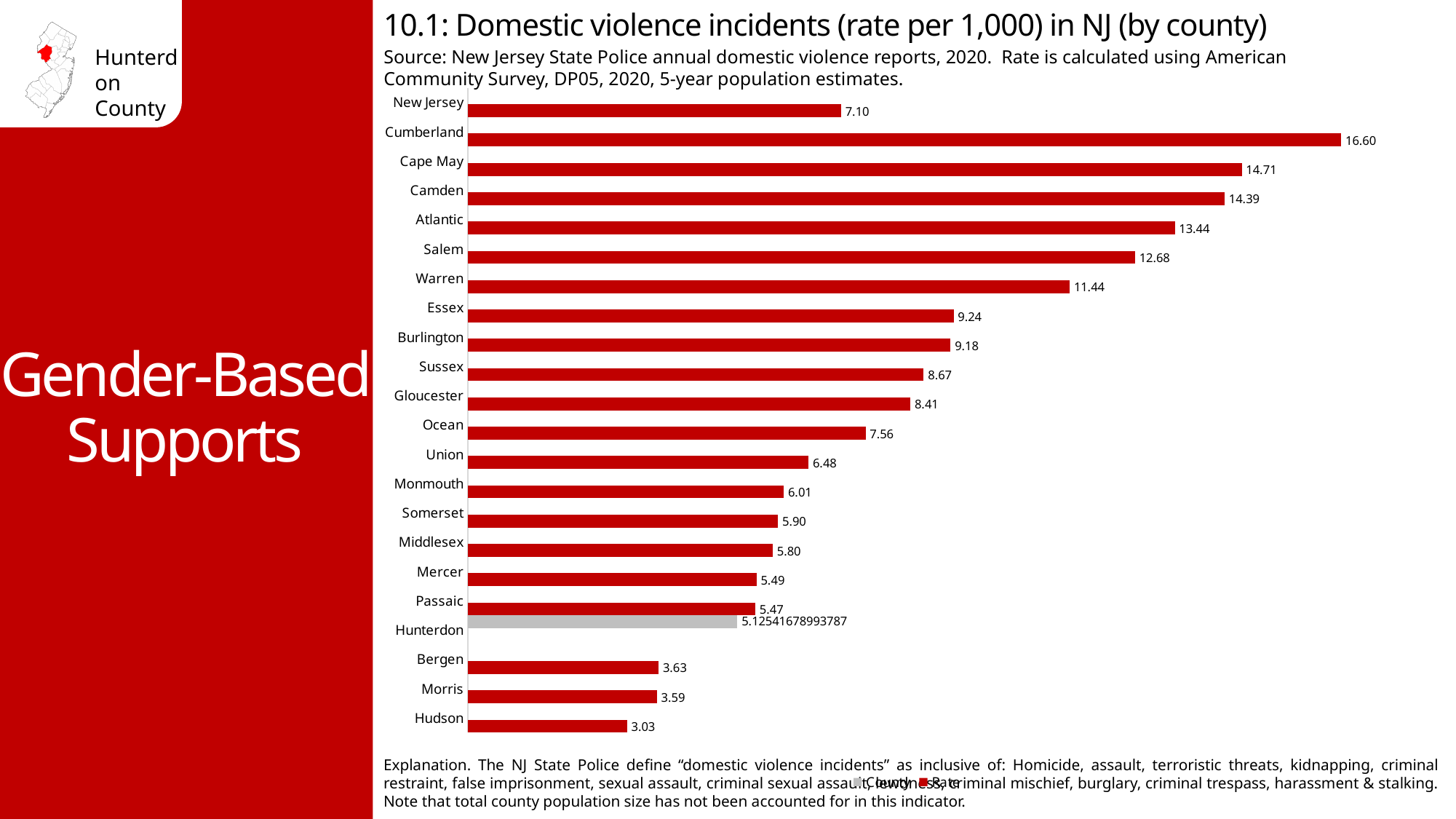
What is the difference between the rates for Cape May and Camden? 0.32 What is the domestic violence incident rate per 1,000 for Cumberland? 16.60 How many bars (categories) are shown in the chart? 22 Which has a higher rate, Warren or Essex? Warren Which county has the highest domestic violence incident rate? Cumberland Which county's bar is shown in gray rather than red? Hunterdon Which county has the lowest domestic violence incident rate? Hudson What value is printed for Hunterdon? 5.12541678993787 What is the rate shown for Hudson? 3.03 What is the rate shown for New Jersey as a whole? 7.10 What is the difference between the rates for Cumberland and Hudson? 13.57 What kind of chart is shown on the slide? Bar chart